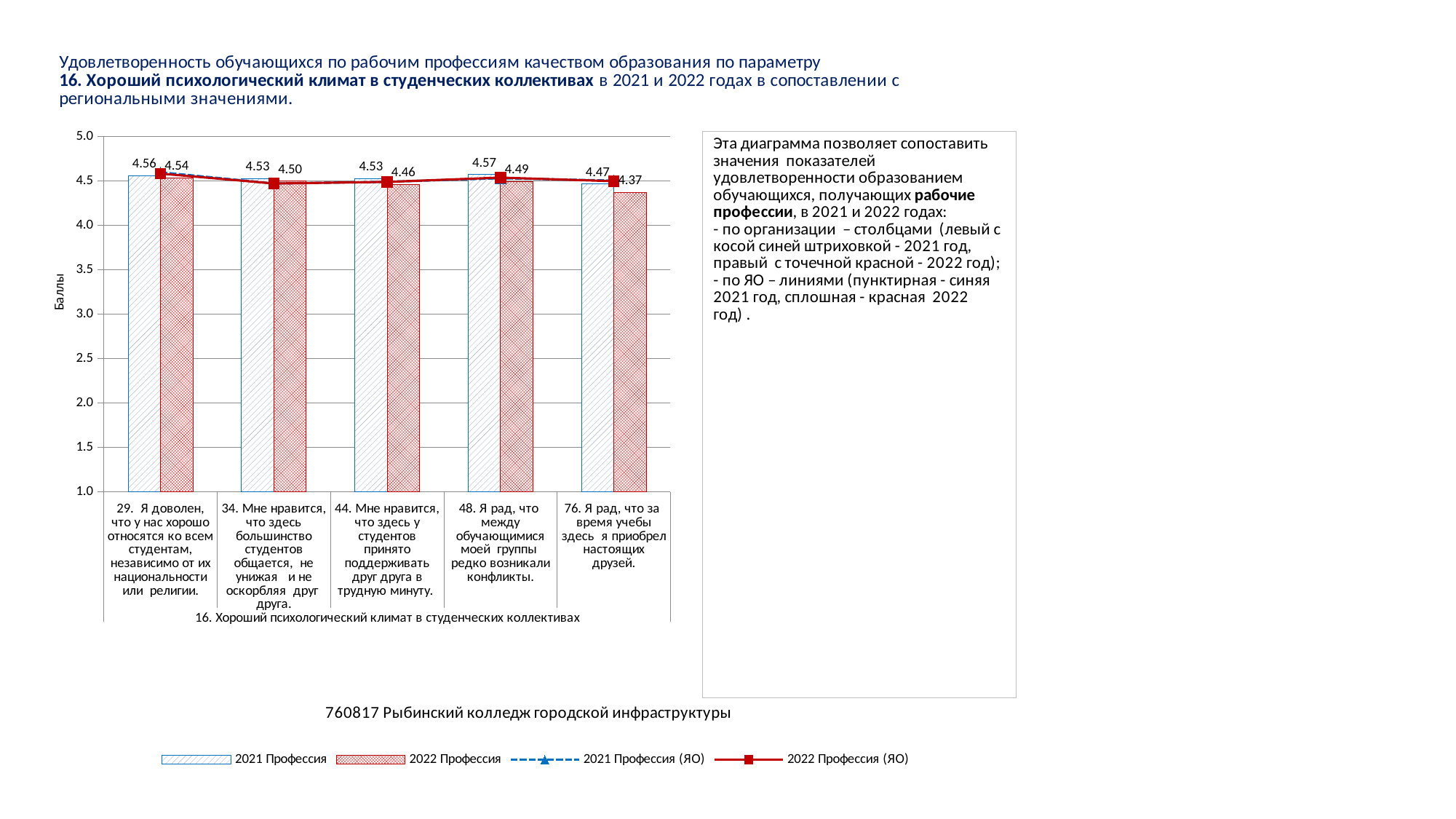
How many items (categories) are shown on the x axis? 5 What is the value of the 2022 Профессия bar for item 34? 4.50 How many series does the legend list? 4 What is the title of the vertical axis? Баллы Which item has the lowest 2022 Профессия value? 76. Я рад, что за время учебы здесь я приобрел настоящих друзей. What is the value of the 2022 Профессия bar for item 76 (Я рад, что за время учебы здесь я приобрел настоящих друзей)? 4.37 What is the difference between the 2021 and 2022 Профессия values for item 44? 0.07 For item 48, which is larger: the 2021 Профессия value or the 2022 Профессия value? 2021 Профессия Is the 2022 Профессия (ЯО) line value for item 29 greater or less than 4.0? greater What is the difference between the 2021 and 2022 Профессия values for item 76? 0.10 What is the value of the 2021 Профессия bar for item 29 (Я доволен, что у нас хорошо относятся ко всем студентам...)? 4.56 Which item has the highest 2021 Профессия value? 48. Я рад, что между обучающимися моей группы редко возникали конфликты.